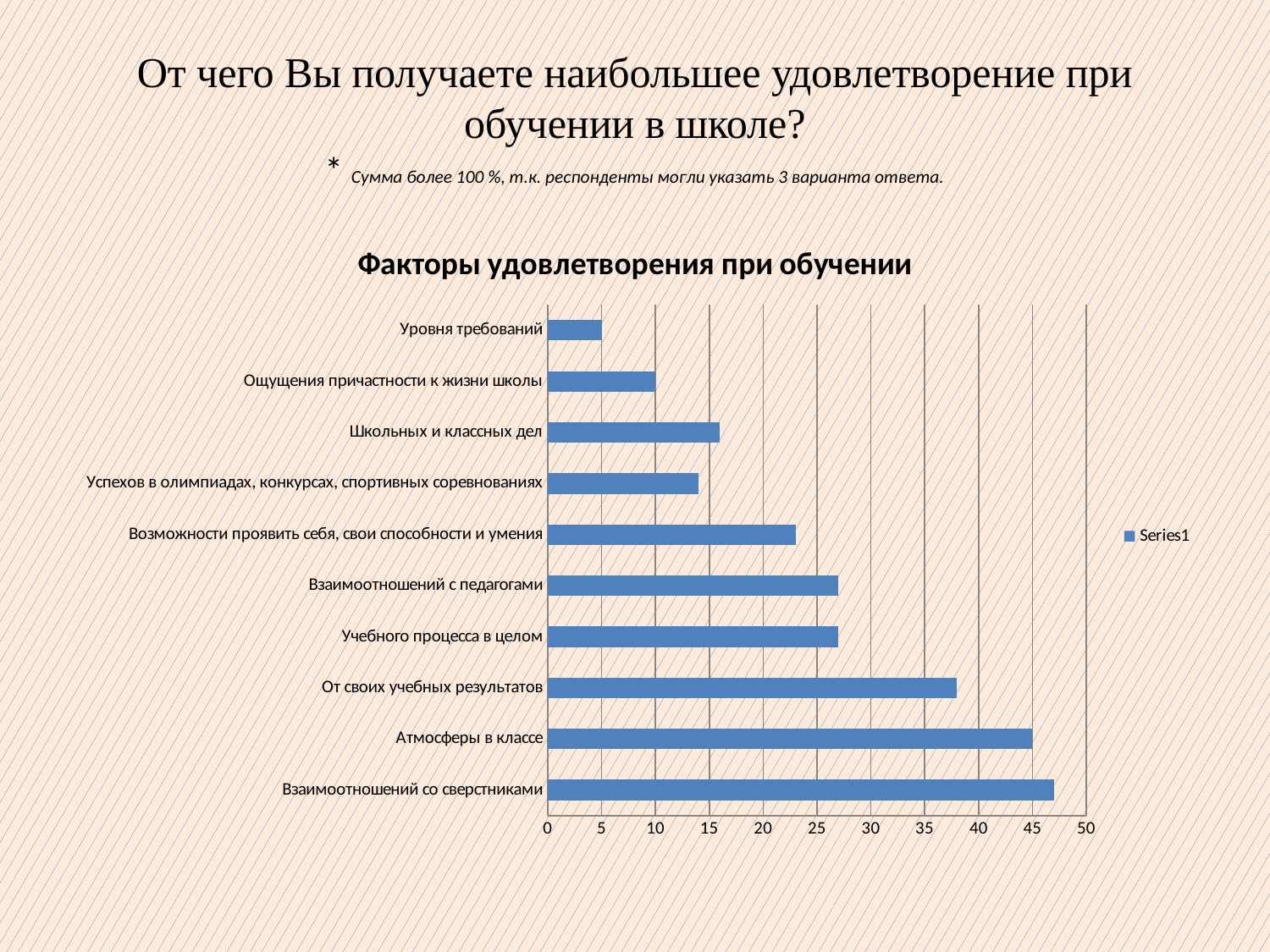
Which is larger: the value for От своих учебных результатов or the value for Успехов в олимпиадах, конкурсах, спортивных соревнованиях? От своих учебных результатов What is the value for Уровня требований? 5 Which category has the lowest value in the chart? Уровня требований What is the title of the chart? Факторы удовлетворения при обучении What kind of chart is shown on the slide? Bar chart How many categories are plotted in the chart? 10 Is the value for Взаимоотношений со сверстниками greater or less than 45? greater Is the value for Возможности проявить себя, свои способности и умения greater or less than 25? less What is the value for Ощущения причастности к жизни школы? 10 Which category has the highest value in the chart? Взаимоотношений со сверстниками How many series does the legend list? 1 Is the value for От своих учебных результатов greater or less than 35? greater